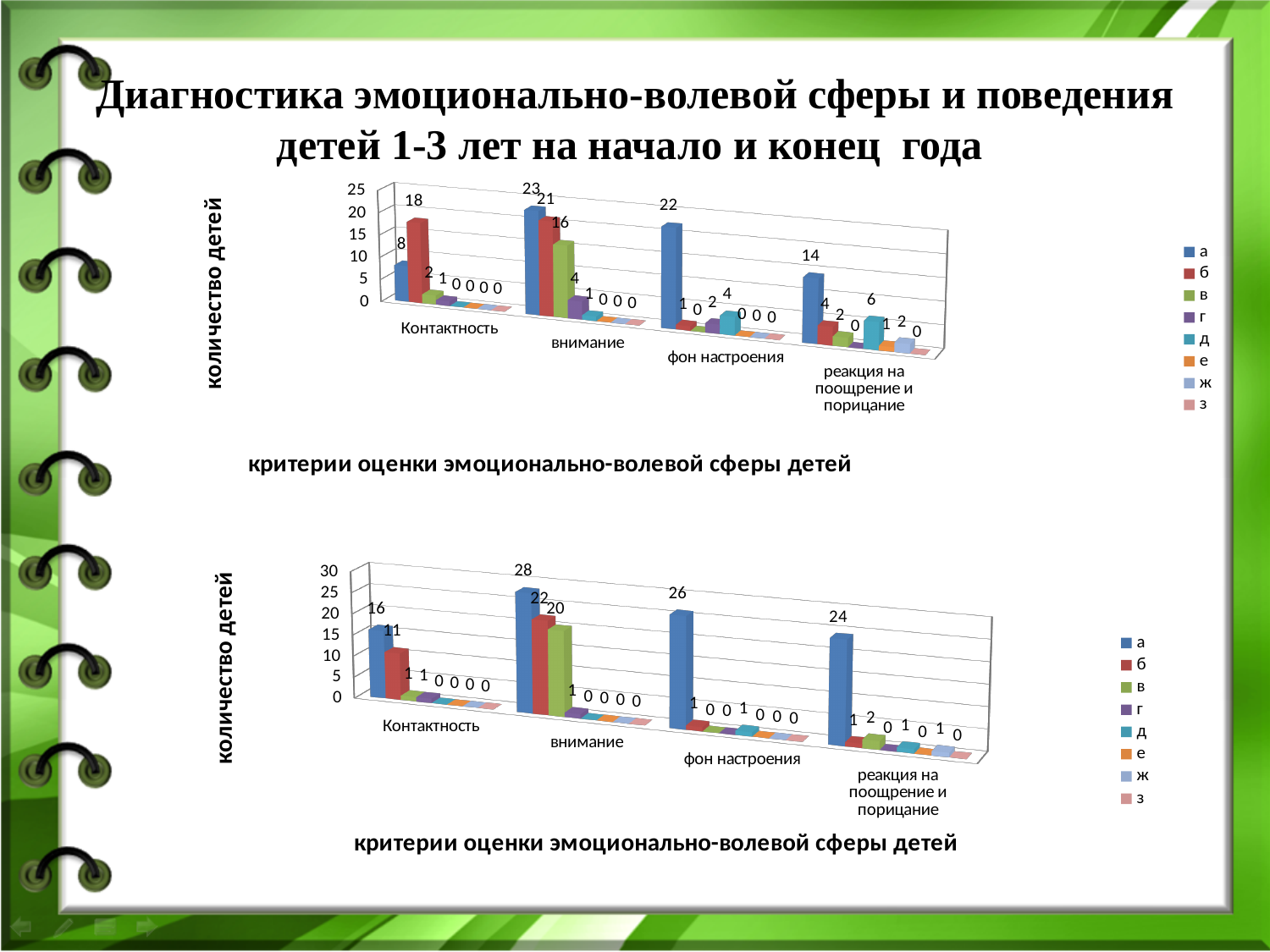
In the bottom chart, which category has the lowest value for series а? Контактность In the bottom chart, what is the value of series в for внимание? 20 In the top chart, what is the value of series а for внимание? 23 How many series does the legend of the bottom chart list? 8 In the bottom chart, what is the value of series а for фон настроения? 26 In the bottom chart, what is the difference between series а for внимание and series а for реакция на поощрение и порицание? 4 In the top chart, what is the difference between series а and series б for Контактность? 10 In the top chart, which category has the highest value for series а? внимание What kind of chart is the bottom chart? bar chart In the top chart, what is the value of series б for Контактность? 18 In the top chart, which is larger for реакция на поощрение и порицание: series б or series д? series д How many categories are shown on the x axis of the top chart? 4